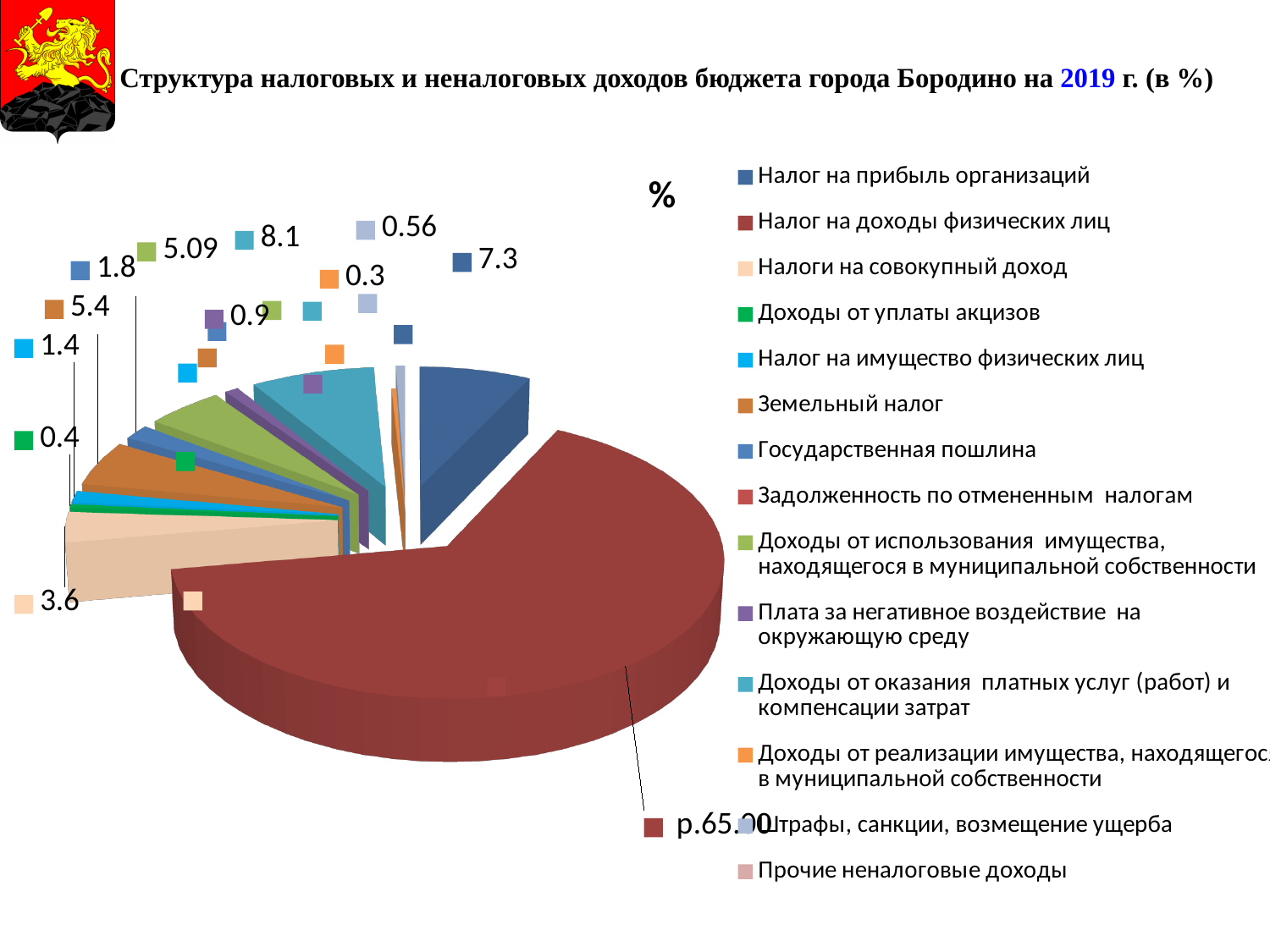
What is the value for Налог на имущество физических лиц? 1.4 What is the value for Доходы от использования имущества, находящегося в муниципальной собственности? 5.09 Which is larger: Доходы от оказания платных услуг (работ) и компенсации затрат or Налог на прибыль организаций? Доходы от оказания платных услуг (работ) и компенсации затрат What is the difference between the values for Доходы от оказания платных услуг (работ) и компенсации затрат and Налог на прибыль организаций? 0.8 What is the value for Штрафы, санкции, возмещение ущерба? 0.56 What is the value for Земельный налог? 5.4 What is the value for Налоги на совокупный доход? 3.6 What is the value for Налог на прибыль организаций? 7.3 Which category has the largest slice of the pie? Налог на доходы физических лиц What kind of chart is shown on the slide? pie chart How many entries does the legend list? 14 What is the value for Доходы от оказания платных услуг (работ) и компенсации затрат? 8.1